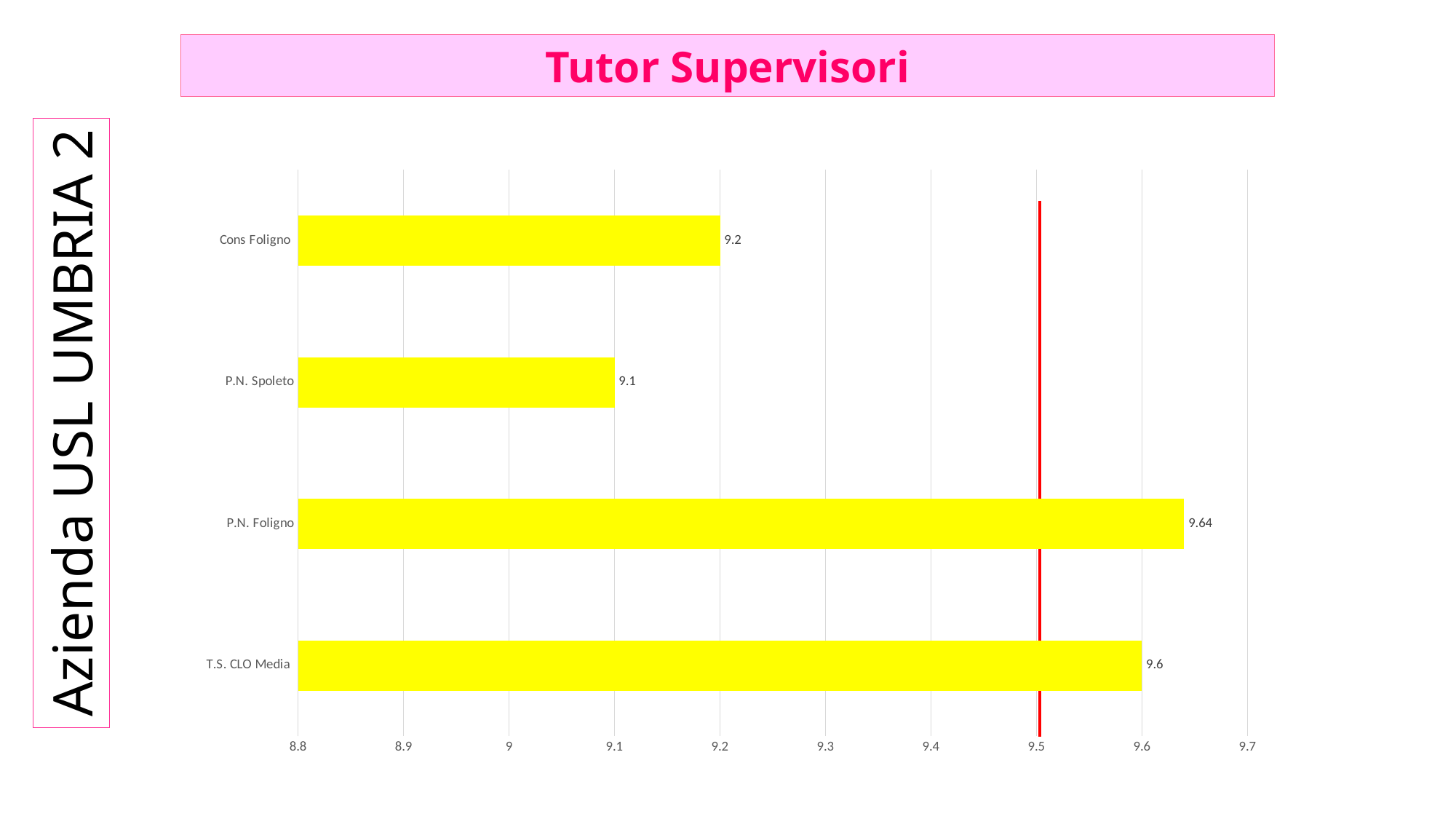
Which category has the lowest value? P.N. Spoleto What is the value for T.S. CLO Media? 9.6 Which category has the highest value? P.N. Foligno What is the value for Cons Foligno? 9.2 Is the value for Cons Foligno greater or less than 9.5? less Which is larger, the value for Cons Foligno or the value for T.S. CLO Media? T.S. CLO Media What kind of chart is shown on the slide? bar chart What is the difference between the values for Cons Foligno and P.N. Spoleto? 0.1 What is the value for P.N. Foligno? 9.64 What is the value for P.N. Spoleto? 9.1 How many categories are shown in the chart? 4 What is the difference between the values for P.N. Foligno and P.N. Spoleto? 0.54